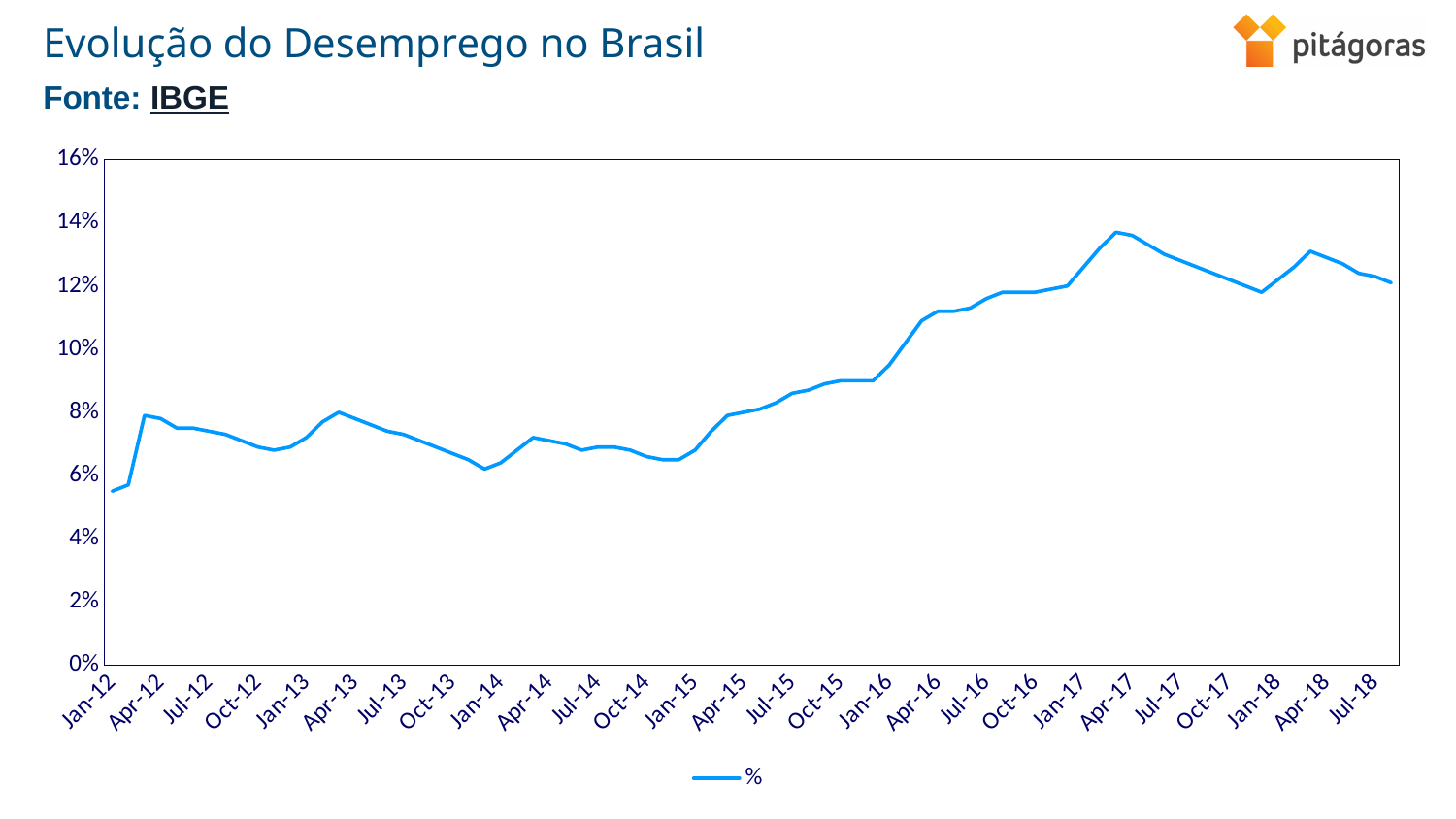
How many series does the legend list? 1 Around which x-axis label does the line reach its highest value? Apr-17 What is the title of the chart on the slide? Evolução do Desemprego no Brasil At which x-axis label is the line at its lowest value? Jan-12 Is the value for Apr-16 greater or less than 10%? greater Is the value for Jan-14 greater or less than 8%? less Is the value for Apr-17 greater or less than 12%? greater Which is larger, the value for Jul-17 or the value for Jul-13? Jul-17 Does the line generally rise or fall between Jan-15 and Apr-17? rise What kind of chart is shown on the slide? line chart What is the legend entry for the plotted line? %